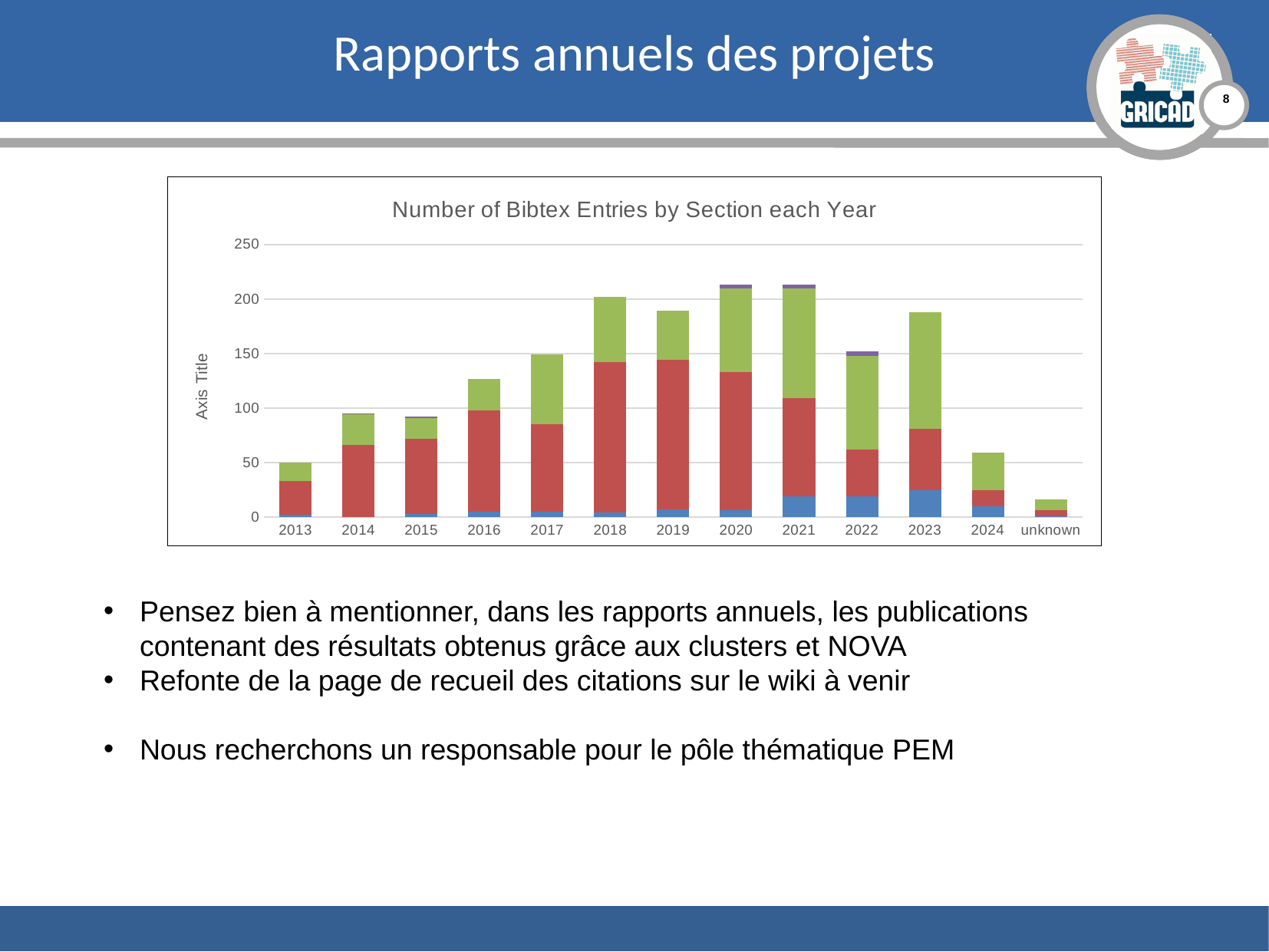
What kind of chart is shown on the slide? Stacked bar chart Is the total value for unknown greater or less than 50? less Is the total value for 2013 greater or less than 100? less What is the title of the chart? Number of Bibtex Entries by Section each Year Is the total value for 2016 greater or less than 100? greater Which category has the lowest total bar in the chart? unknown How many categories are shown along the x axis of the chart? 13 What label is shown on the vertical axis of the chart? Axis Title Which has the larger total bar, 2018 or 2024? 2018